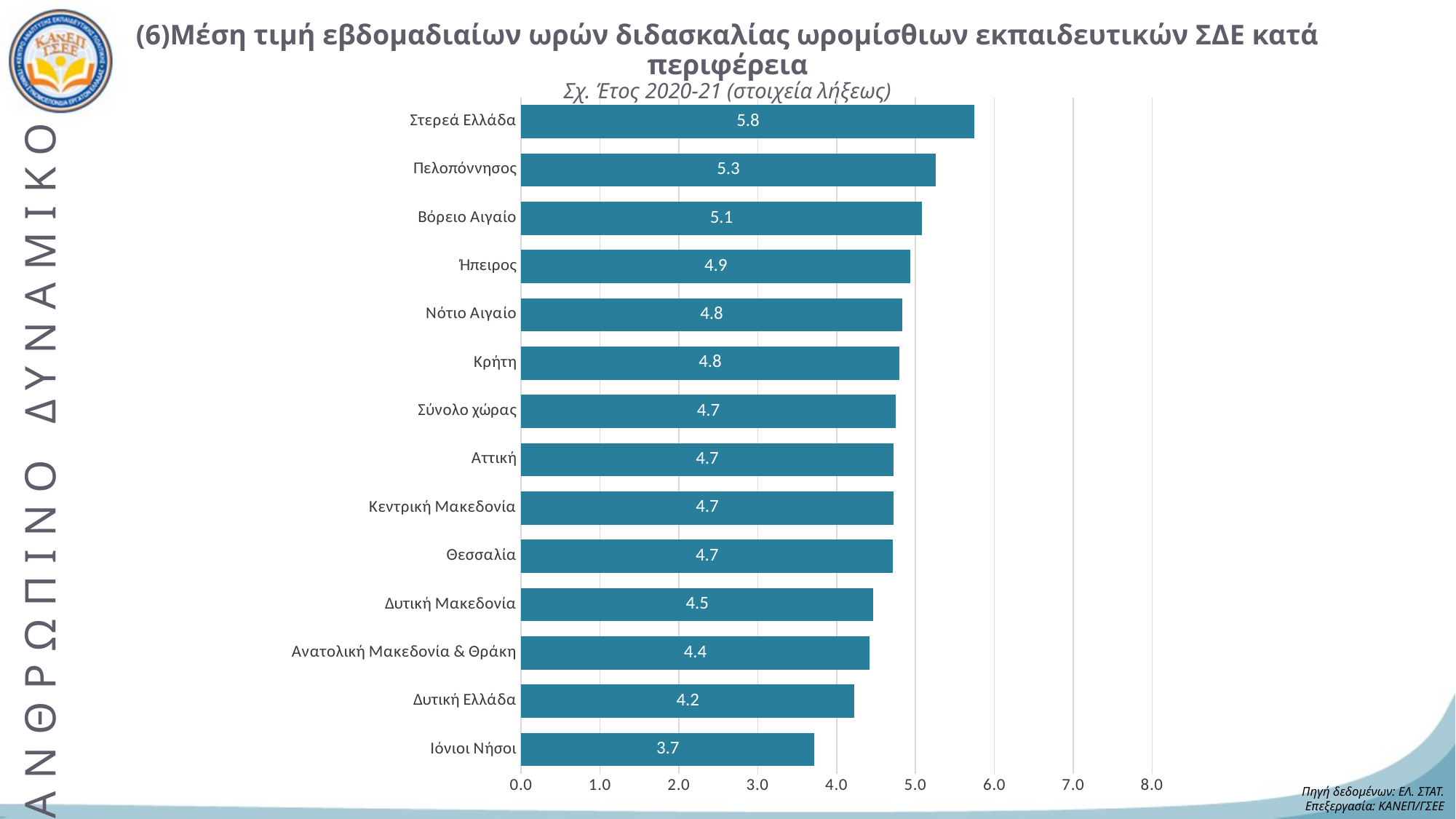
What is the difference between the values for Στερεά Ελλάδα and Ιόνιοι Νήσοι? 2.1 What school year does the chart subtitle refer to? 2020-21 Is the value for Βόρειο Αιγαίο greater or less than 5.0? greater What is the value for Στερεά Ελλάδα? 5.8 Which region has the highest value? Στερεά Ελλάδα What kind of chart is shown on the slide? bar chart Which region has the lowest value? Ιόνιοι Νήσοι What is the value for Σύνολο χώρας? 4.7 How many categories are shown on the chart? 14 What is the value for Ιόνιοι Νήσοι? 3.7 Which is larger, the value for Πελοπόννησος or the value for Δυτική Ελλάδα? Πελοπόννησος What is the value for Δυτική Μακεδονία? 4.5